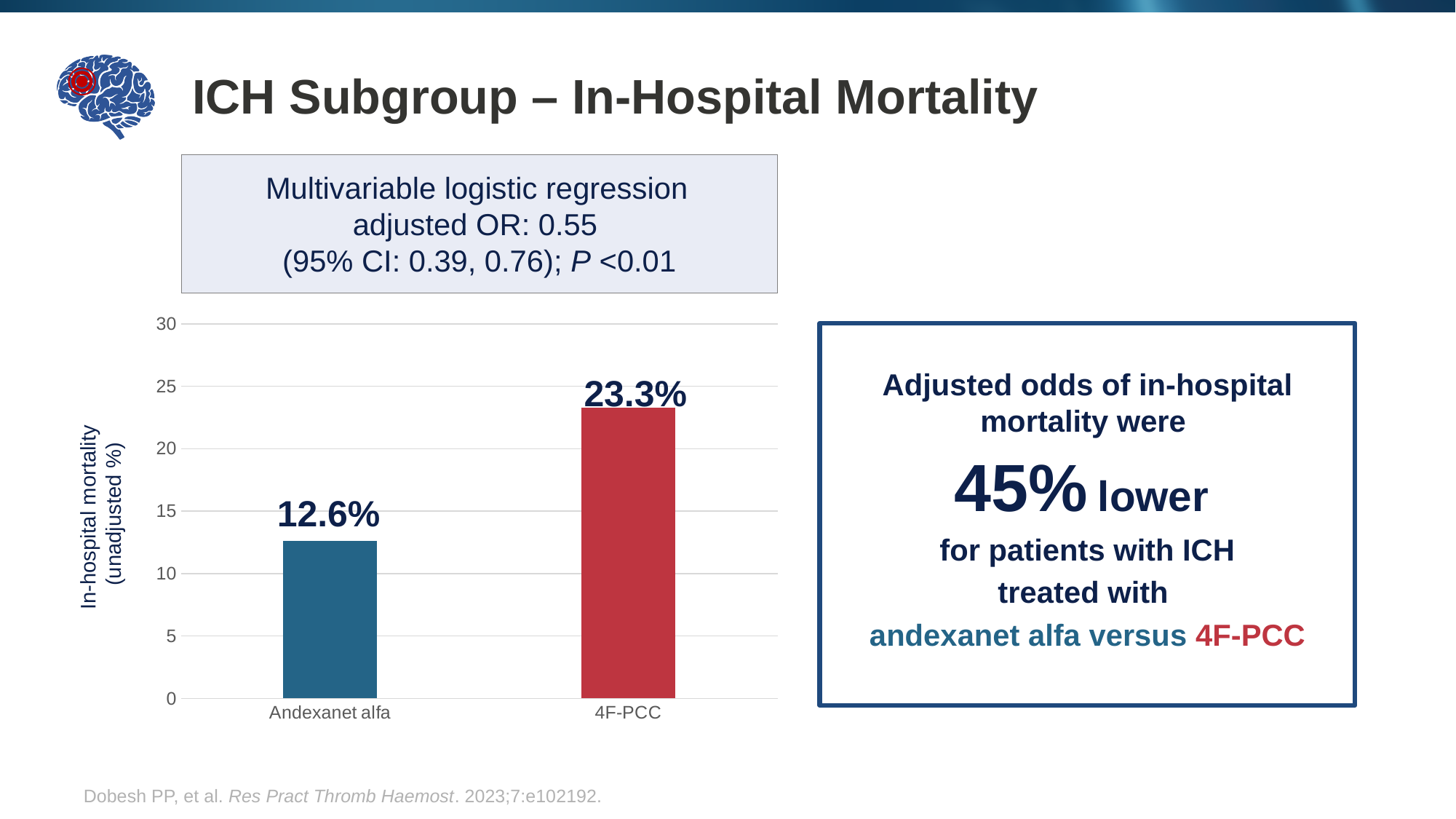
What kind of chart is shown on the slide? Bar chart Is the value for 4F-PCC greater or less than 20? greater Which category has the highest in-hospital mortality? 4F-PCC What is the in-hospital mortality value for Andexanet alfa? 12.6% What is the difference in in-hospital mortality between 4F-PCC and Andexanet alfa? 10.7% Is the value for Andexanet alfa greater or less than 15? less What is the label of the y axis of the chart? In-hospital mortality (unadjusted %) What is the in-hospital mortality value for 4F-PCC? 23.3% How many categories are shown on the x axis of the chart? 2 What colour is the bar for 4F-PCC? Red Which category has the lowest in-hospital mortality? Andexanet alfa Which is larger, the in-hospital mortality for Andexanet alfa or for 4F-PCC? 4F-PCC